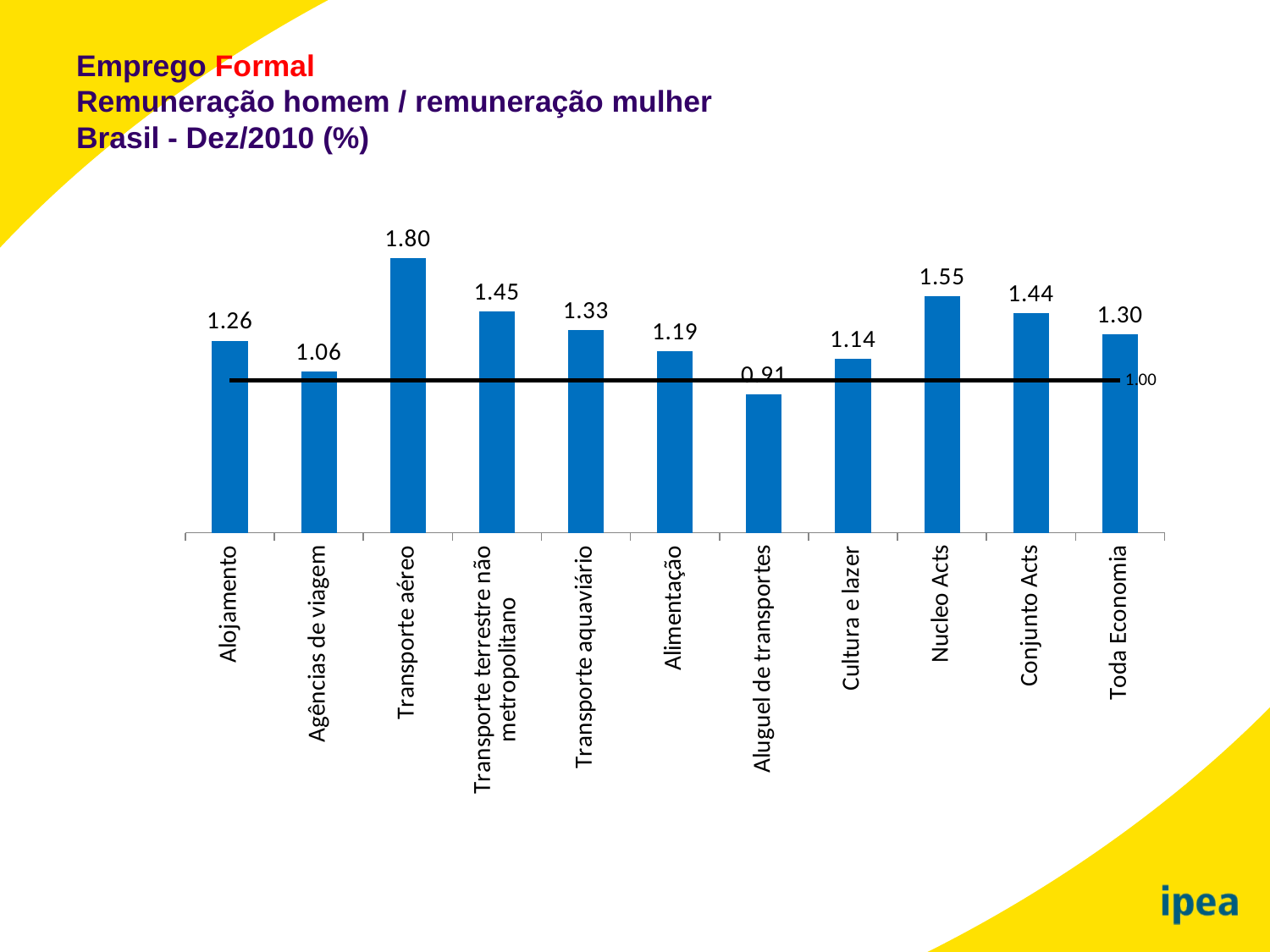
What is the difference between the values for Transporte aéreo and Toda Economia? 0.50 What is the value for Transporte aéreo? 1.80 Which category has the lowest value? Aluguel de transportes What is the difference between the values for Nucleo Acts and Conjunto Acts? 0.11 What is the value for Agências de viagem? 1.06 What is the value for Toda Economia? 1.30 What kind of chart is shown on the slide? bar chart What is the value for Nucleo Acts? 1.55 Which category has the highest value? Transporte aéreo Is the value for Aluguel de transportes greater or less than 1.00? less Which is larger, the value for Alojamento or the value for Alimentação? Alojamento How many categories are shown in the chart? 11